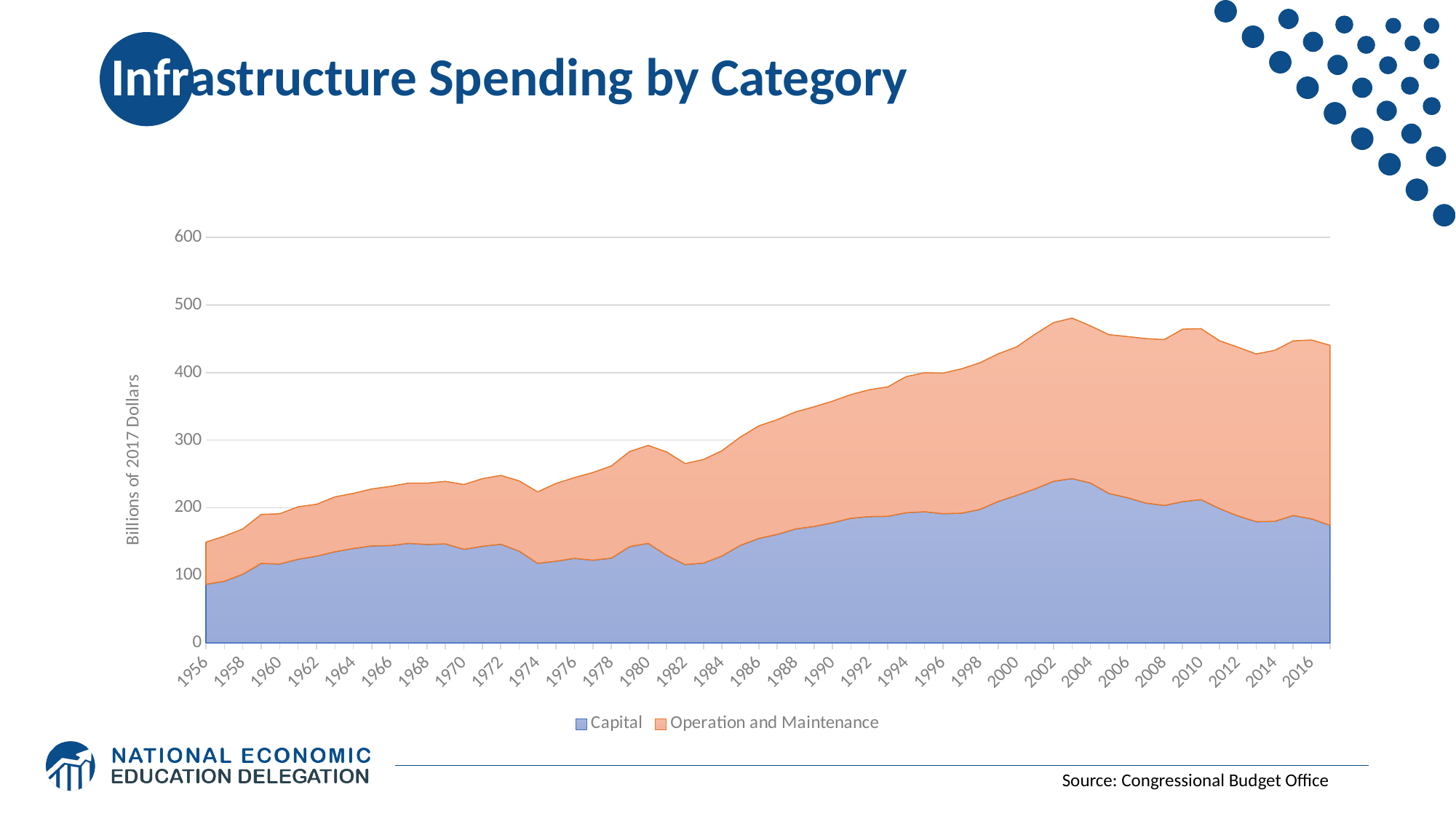
Is the Capital value in 2003 greater or less than 200? greater How many series does the legend list? 2 Is the Capital value in 1956 greater or less than 100? less Is total infrastructure spending higher in 1956 or in 2003? 2003 Is the total infrastructure spending (top of the stacked area) in 1956 greater or less than 200? less What is the label on the vertical axis? Billions of 2017 Dollars What kind of chart is shown on the slide? Stacked area chart Overall, does total infrastructure spending rise or fall from 1956 to 2017? rise What are the two series named in the legend? Capital; Operation and Maintenance